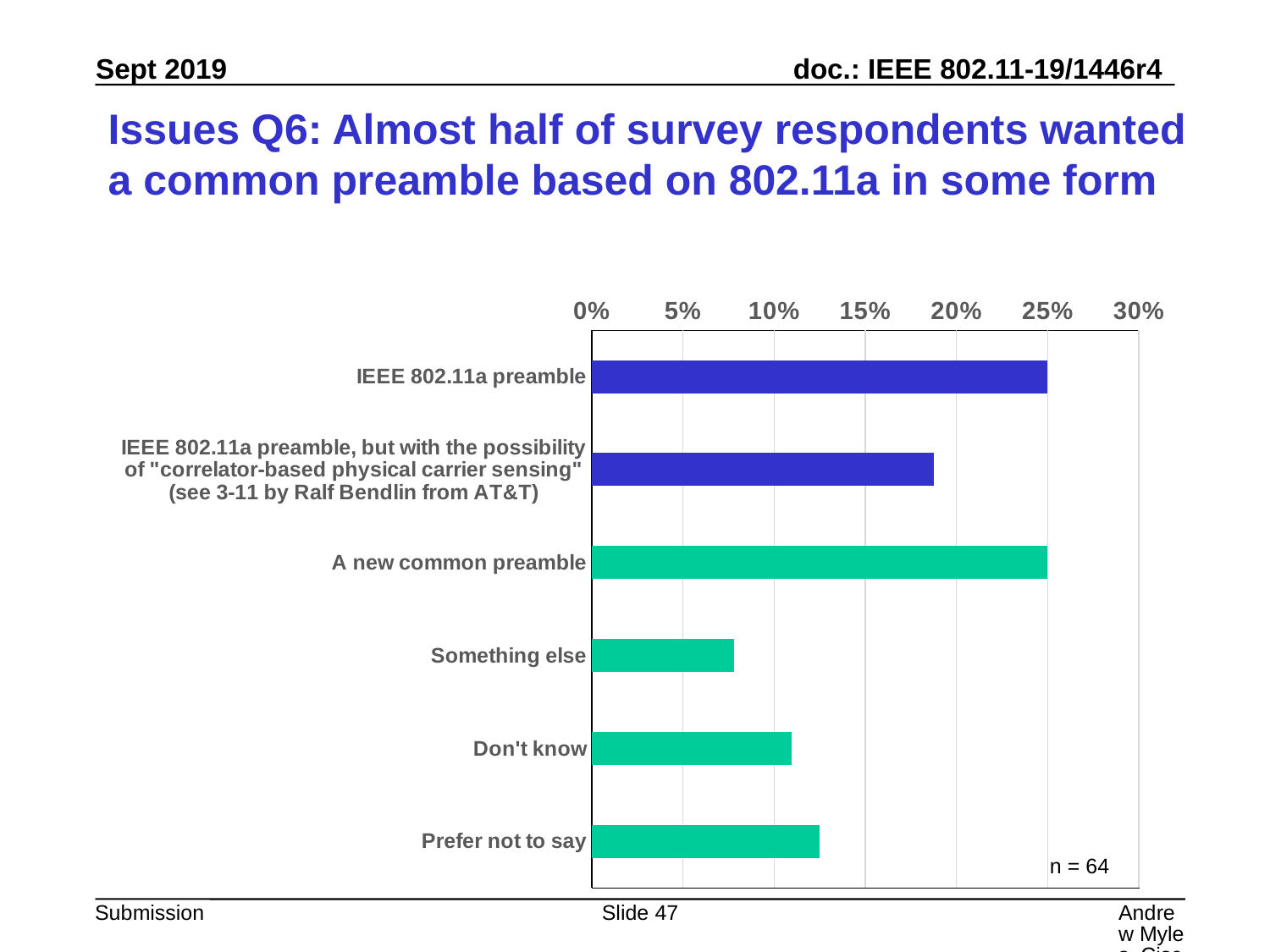
What is the sample size (n) noted on the chart? n = 64 How many bars in the chart are coloured blue? 2 How many categories are plotted in the chart? 6 Which is larger, the value for "Don't know" or the value for "Something else"? Don't know What kind of chart is shown on the slide? bar chart Is the value for "Something else" greater or less than 10%? less Is the value for "IEEE 802.11a preamble, but with the possibility of 'correlator-based physical carrier sensing'" greater or less than 20%? less What is the value for "A new common preamble"? 25% Is the value for "IEEE 802.11a preamble, but with the possibility of 'correlator-based physical carrier sensing'" greater or less than 15%? greater Which category has the lowest value in the chart? Something else What is the value for "IEEE 802.11a preamble"? 25%